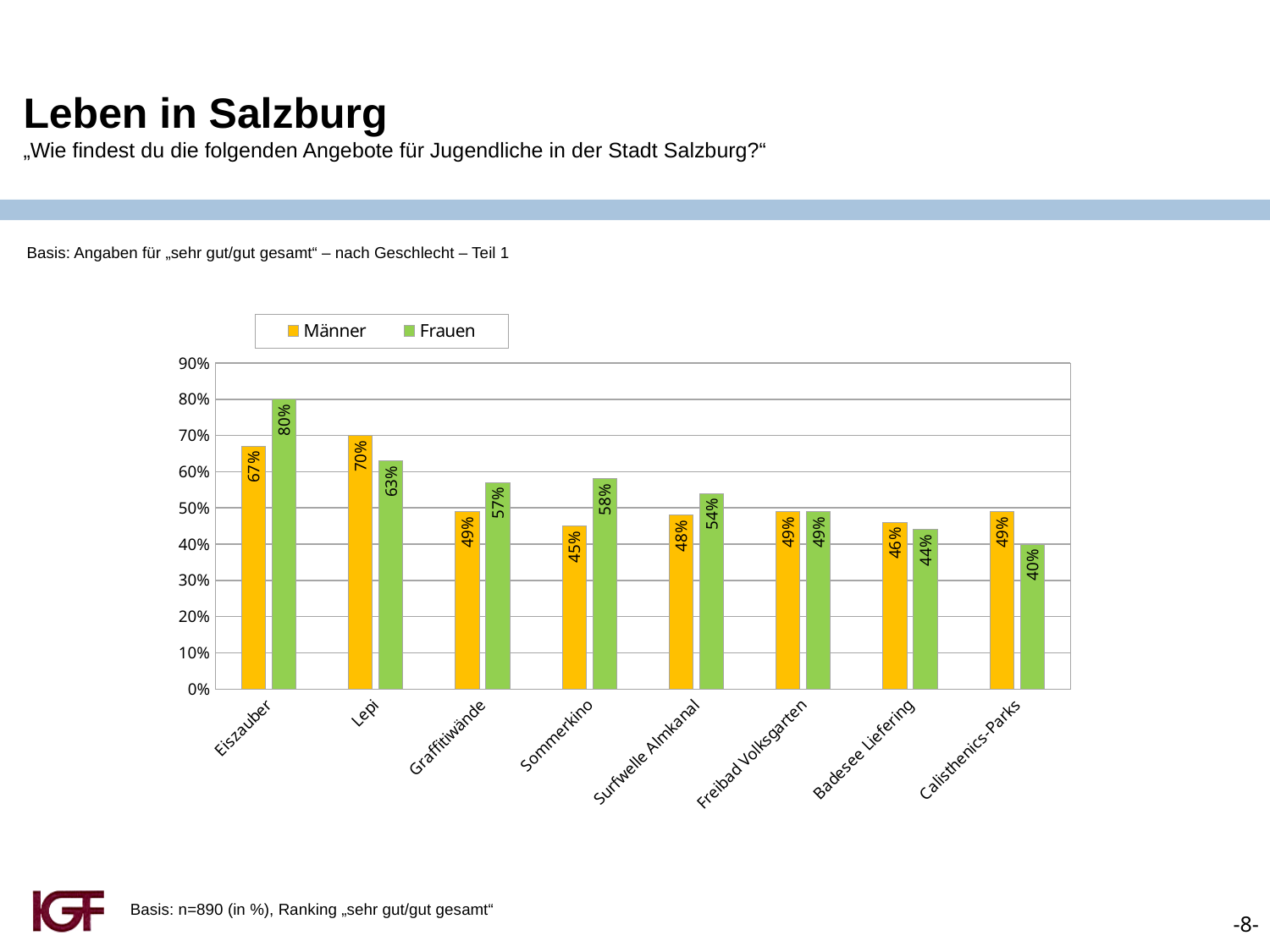
What is the difference between the Männer and Frauen values for Badesee Liefering? 2% What is the value for Frauen for Sommerkino? 58% What is the value for Männer for Eiszauber? 67% What is the difference between the Frauen and Männer values for Eiszauber? 13% How many series does the legend list? 2 Which category has the highest value for Frauen? Eiszauber Which category has the lowest value for Männer? Sommerkino Which colour represents the Frauen series in the legend? Green Which is larger for Lepi, the Männer value or the Frauen value? Männer What is the value for Frauen for Calisthenics-Parks? 40% How many categories are shown on the x axis? 8 What kind of chart is shown on the slide? Bar chart